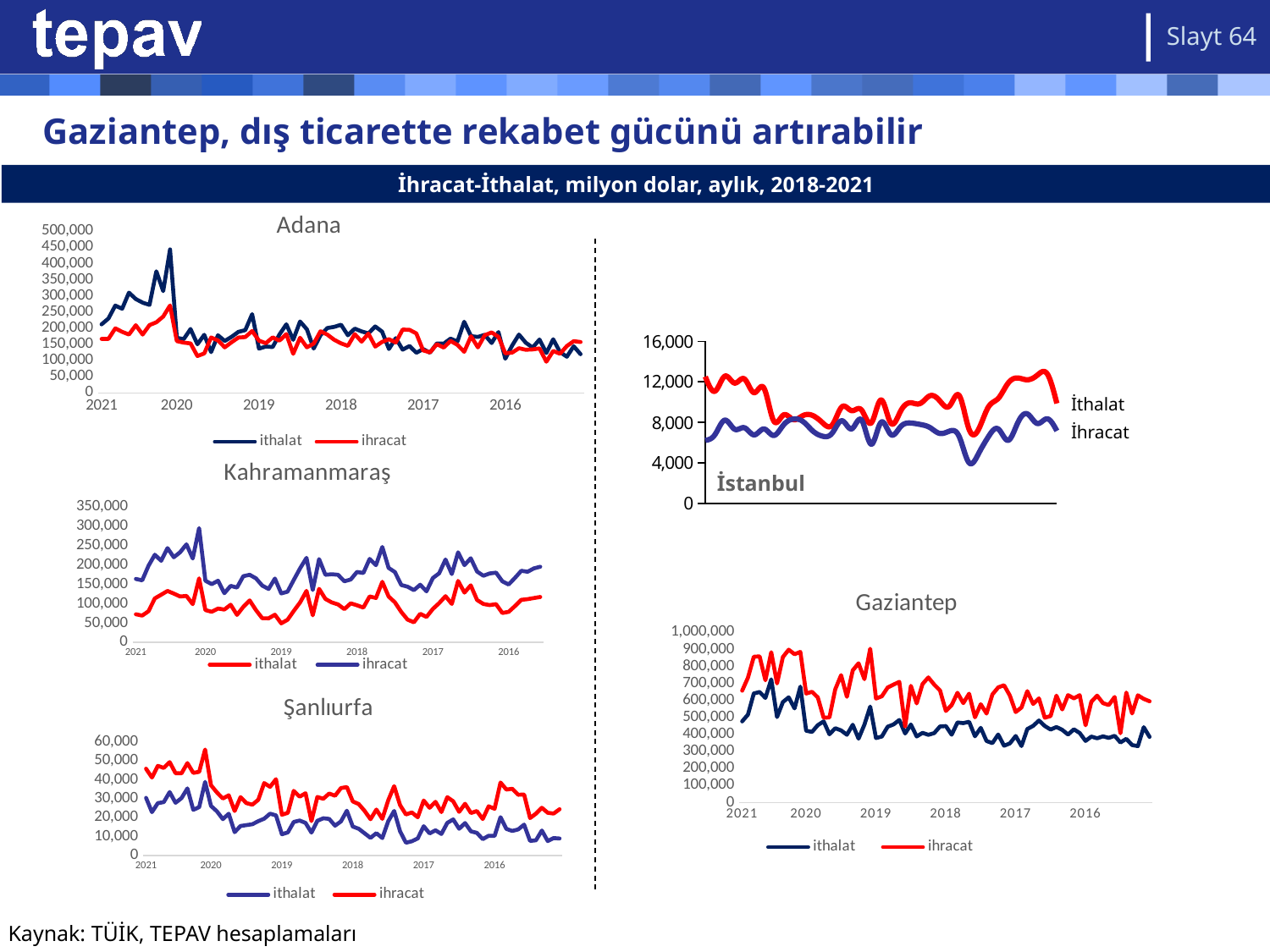
In the İstanbul chart, is the lowest value of İhracat greater or less than 6,000? less In the Gaziantep chart, which series is generally higher, ithalat or ihracat? ihracat What is the title printed in the band above the charts? İhracat-İthalat, milyon dolar, aylık, 2018-2021 In the Şanlıurfa chart, is the peak value of ihracat greater or less than 50,000? greater In the Adana chart, is the peak value of ithalat greater or less than 400,000? greater In the Gaziantep chart, do the ihracat values overall rise or fall from left to right along the x axis? fall In the Gaziantep chart, what colour is the ihracat line? red In the Kahramanmaraş chart, which series is generally higher, ithalat or ihracat? ihracat How many series does the legend of the Gaziantep chart list? 2 In the İstanbul chart, at the leftmost point (2021), which is larger, İthalat or İhracat? İthalat What kind of chart is the Adana chart? line chart